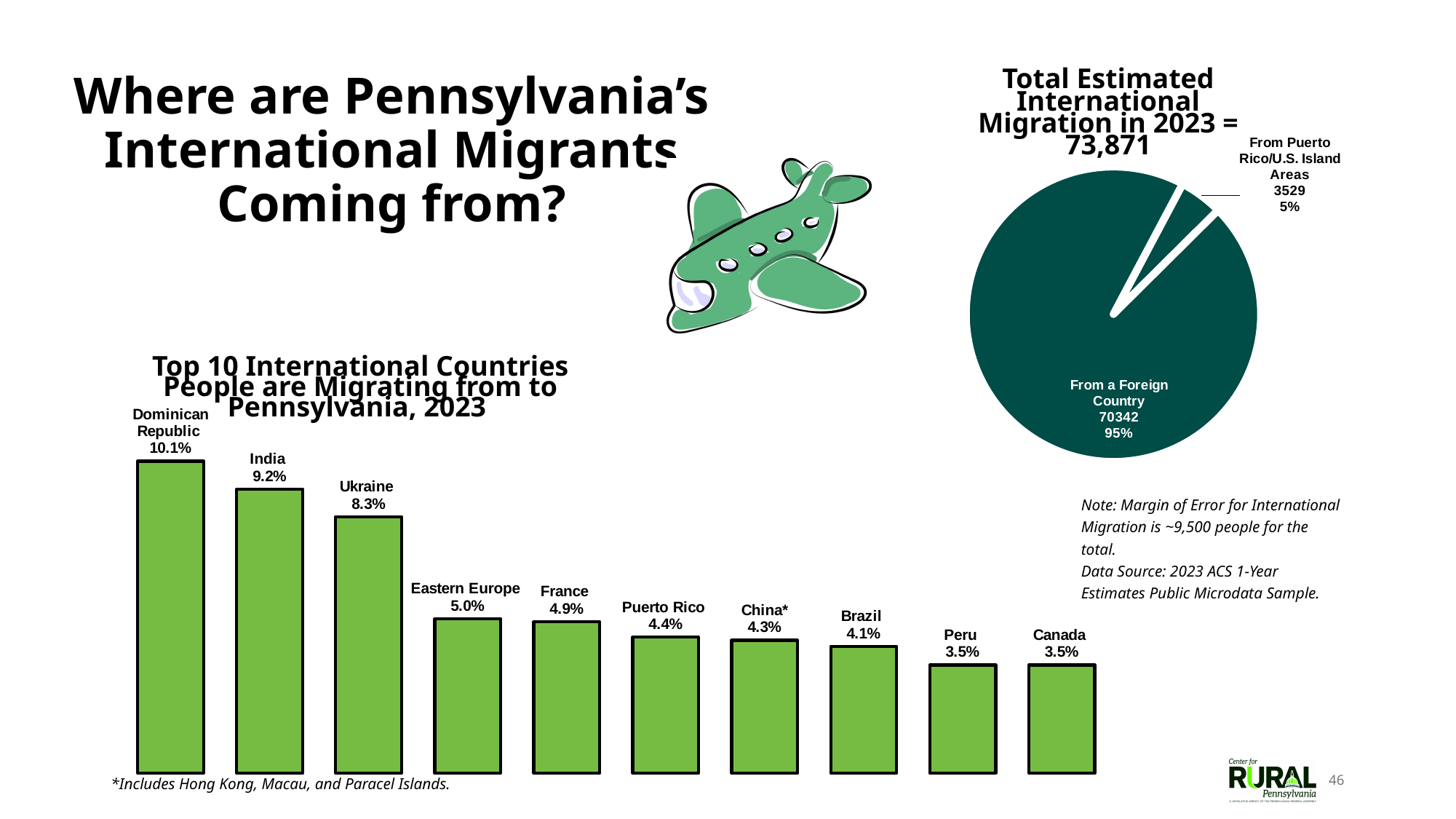
In the 'Total Estimated International Migration in 2023 = 73,871' pie chart, what share of the pie is 'From Puerto Rico/U.S. Island Areas'? 5% How many bars are shown in the 'Top 10 International Countries People are Migrating from to Pennsylvania, 2023' chart? 10 In the 'Top 10 International Countries People are Migrating from to Pennsylvania, 2023' chart, do the values rise or fall from left to right? Fall In the 'Top 10 International Countries People are Migrating from to Pennsylvania, 2023' chart, what is the difference between the values for Dominican Republic and Ukraine? 1.8% What kind of chart is the 'Top 10 International Countries People are Migrating from to Pennsylvania, 2023' chart? Bar chart What kind of chart is the 'Total Estimated International Migration in 2023 = 73,871' chart? Pie chart In the 'Top 10 International Countries People are Migrating from to Pennsylvania, 2023' chart, what is the value for India? 9.2% In the 'Top 10 International Countries People are Migrating from to Pennsylvania, 2023' chart, which is larger, the value for Eastern Europe or the value for Brazil? Eastern Europe In the 'Total Estimated International Migration in 2023 = 73,871' pie chart, what is the value for 'From a Foreign Country'? 70342 In the 'Top 10 International Countries People are Migrating from to Pennsylvania, 2023' chart, which category has the highest value? Dominican Republic How many slices does the 'Total Estimated International Migration in 2023 = 73,871' pie chart have? 2 In the 'Top 10 International Countries People are Migrating from to Pennsylvania, 2023' chart, what is the value for Puerto Rico? 4.4%